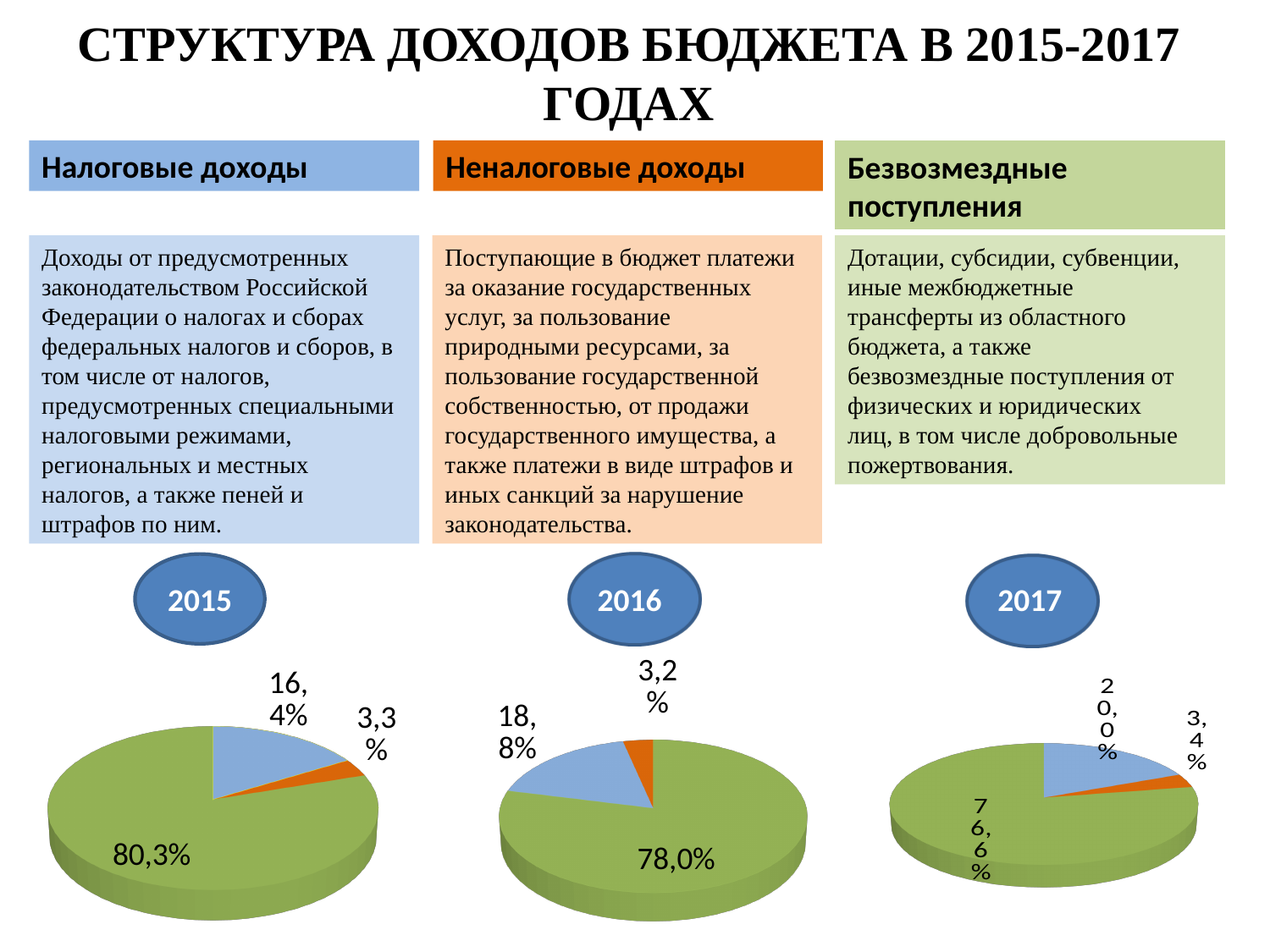
In the 2016 pie chart, what is the value of the orange slice? 3,2% In the 2015 pie chart, what is the value of the largest slice? 80,3% In the 2017 pie chart, what is the value of the blue slice? 20,0% How many pie charts are shown on the slide? 3 Which is larger: the blue slice in the 2015 pie chart or the blue slice in the 2017 pie chart? 2017 In the 2015 pie chart, what is the value of the blue slice? 16,4% What kind of chart is used for the 2015 data? pie chart What is the difference between the largest slice in the 2015 pie chart and the largest slice in the 2017 pie chart? 3,7% In the 2015 pie chart, what is the value of the smallest slice? 3,3% In the 2017 pie chart, what is the value of the smallest slice? 3,4% How many slices does each pie chart have? 3 In the 2016 pie chart, what is the value of the green slice? 78,0%